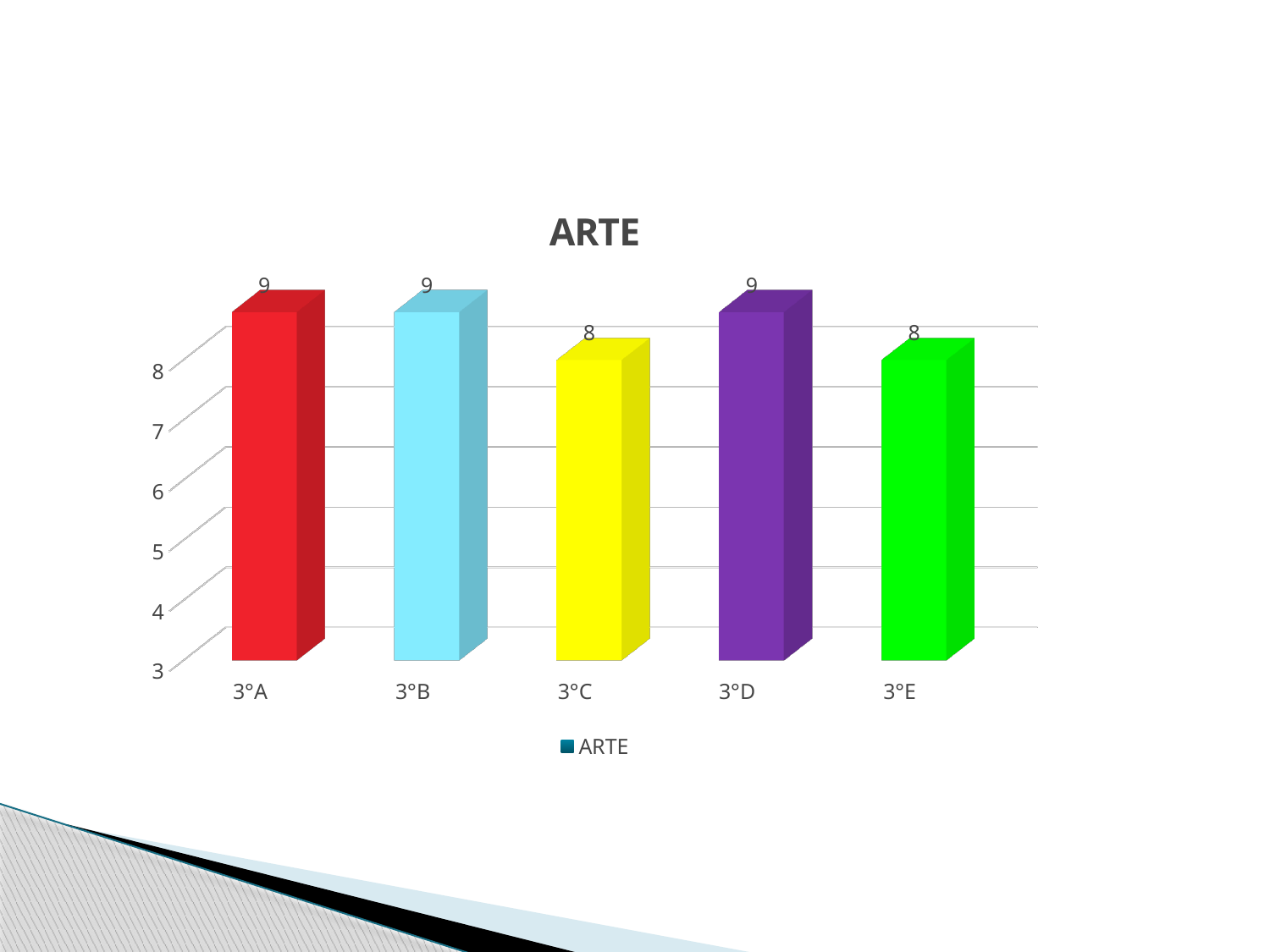
What is the value for 3°E? 8 What is the value for 3°A? 9 What colour is the bar for 3°D? Purple How many categories are shown on the x axis? 5 What kind of chart is shown on the slide? Bar chart What is the title of the chart? ARTE Is the value for 3°D larger than the value for 3°E? Yes What is the difference between the values for 3°A and 3°C? 1 How many series does the legend list? 1 What is the value for 3°C? 8 Which category has the lowest value, 3°B or 3°C? 3°C What is the value for 3°D? 9